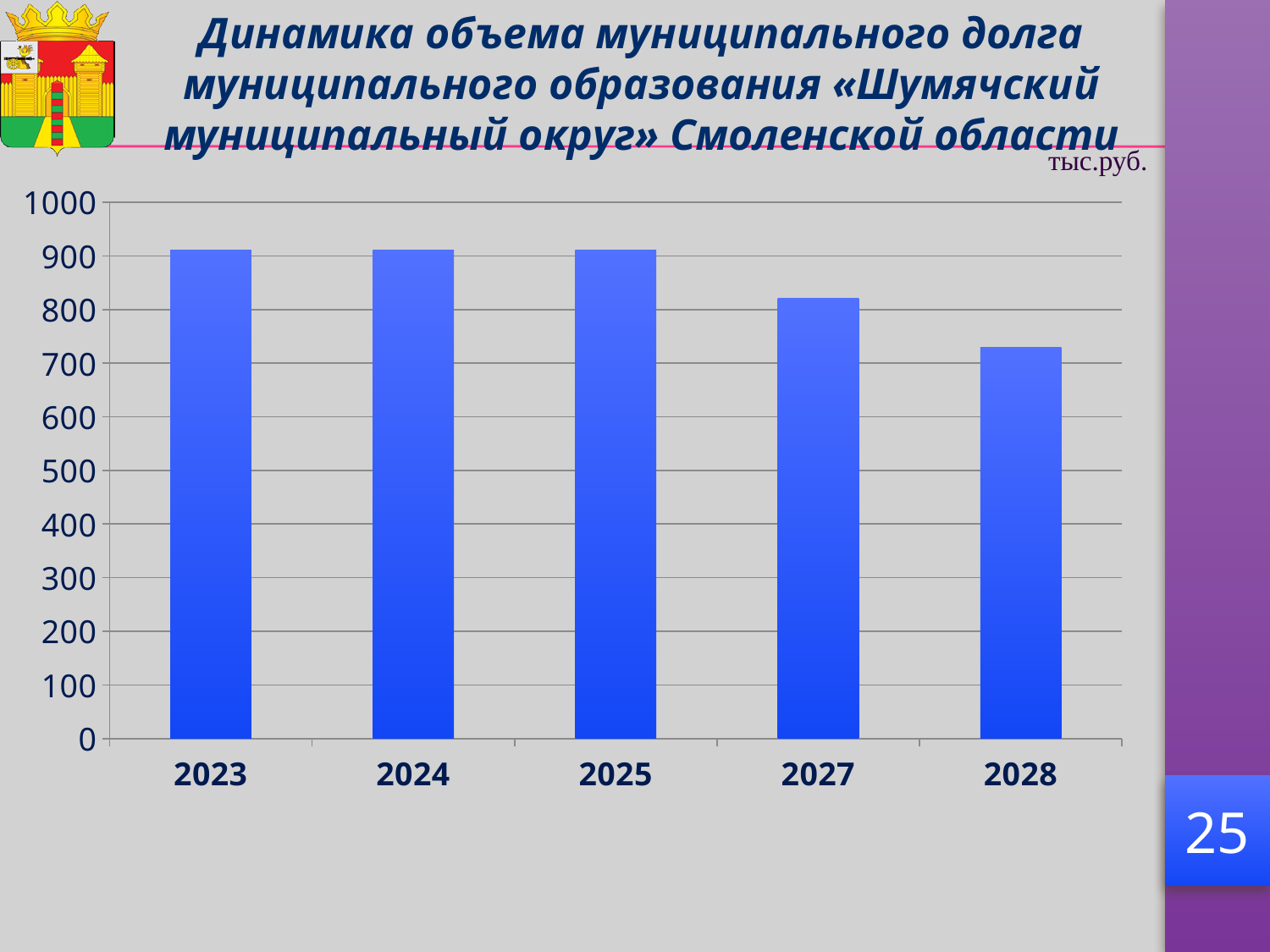
Do the values rise or fall from 2025 to 2028? fall What kind of chart is shown on the slide? bar chart Is the value for 2028 greater or less than 600? greater Is the value for 2023 greater or less than 800? greater Which is larger, the value for 2024 or the value for 2028? 2024 How many years are shown on the x axis of the chart? 5 Which year has the lowest value in the chart? 2028 Is the value for 2027 greater or less than 900? less Which is larger, the value for 2027 or the value for 2028? 2027 What unit of measurement is indicated above the chart? тыс.руб.